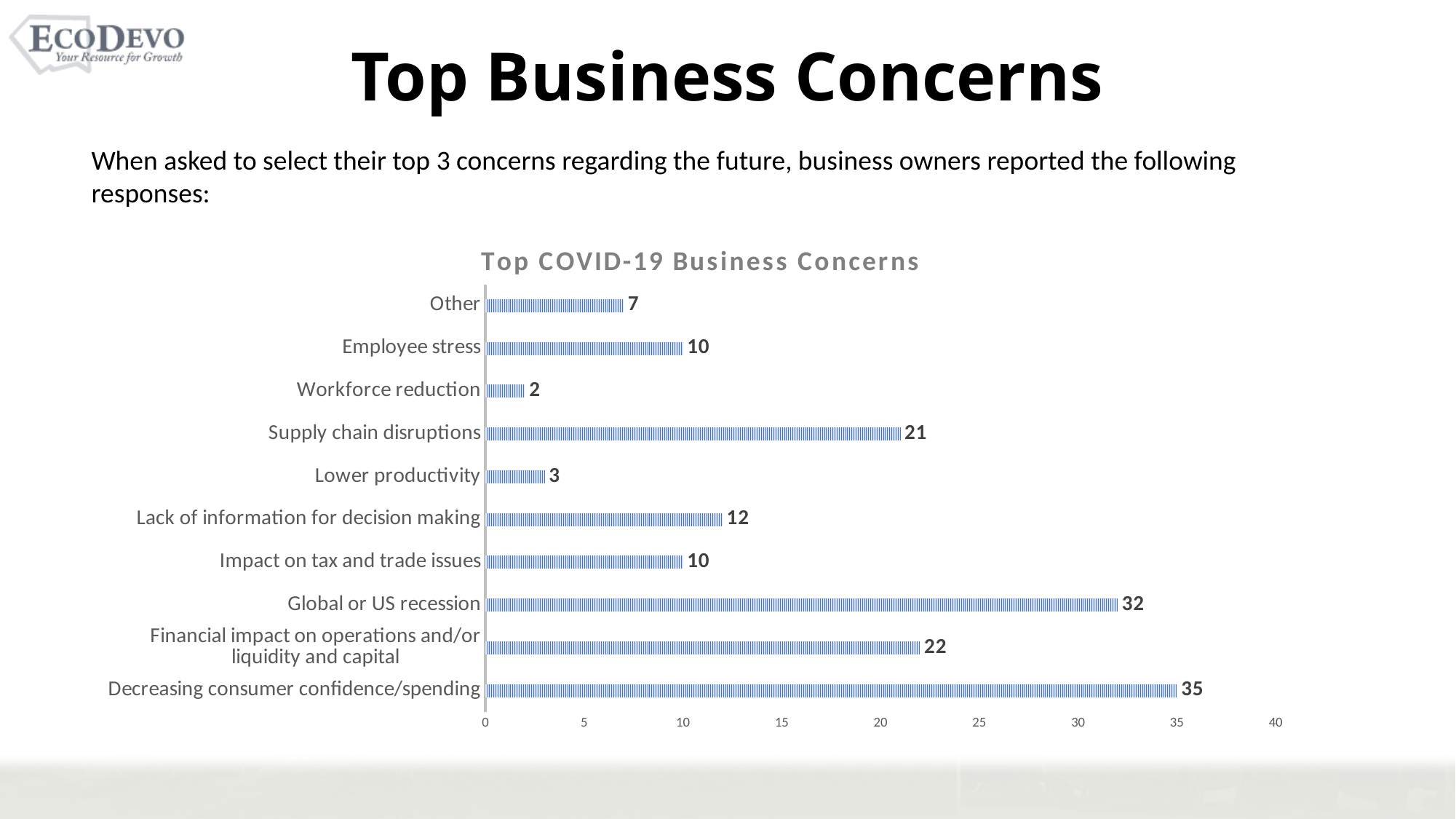
Which category has the lowest value? Workforce reduction What is the value for Supply chain disruptions? 21 Is the value for Global or US recession greater or less than 30? greater What kind of chart is shown on the slide? bar chart Which is larger, Supply chain disruptions or Financial impact on operations and/or liquidity and capital? Financial impact on operations and/or liquidity and capital Which category has the highest value? Decreasing consumer confidence/spending What is the value for Lack of information for decision making? 12 What is the difference between Decreasing consumer confidence/spending and Global or US recession? 3 What is the value for Employee stress? 10 What is the title of the chart? Top COVID-19 Business Concerns What is the value for Global or US recession? 32 How many categories are shown in the chart? 10